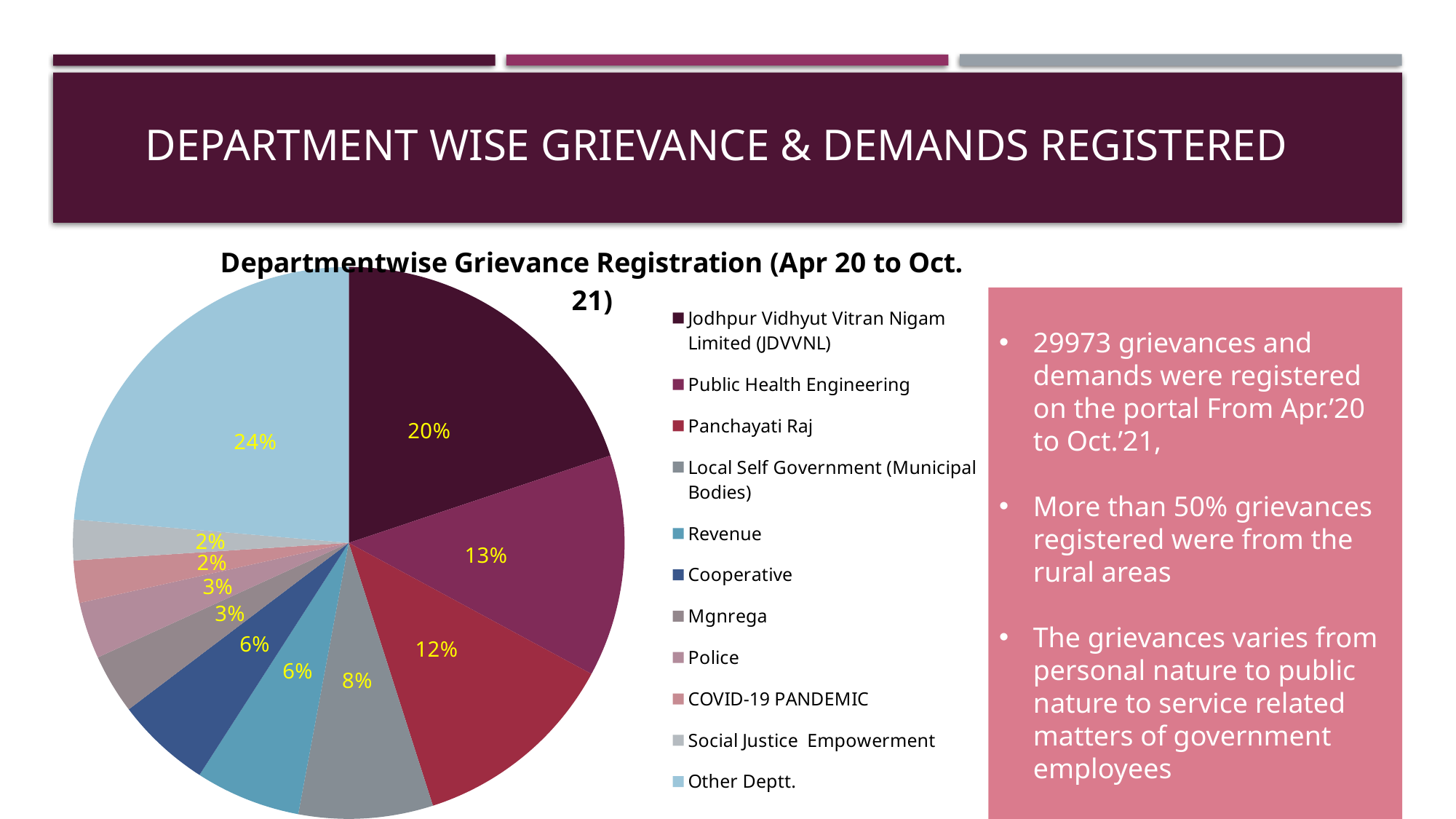
How many categories does the pie chart's legend list? 11 What colour is the slice for Other Deptt.? light blue What is the difference in percentage points between the Other Deptt. slice and the JDVVNL slice? 4 What share of grievances is attributed to Panchayati Raj? 12% What share of grievances is attributed to Local Self Government (Municipal Bodies)? 8% Which is larger, the share for Public Health Engineering or the share for Panchayati Raj? Public Health Engineering What share of grievances is attributed to Public Health Engineering? 13% What share of grievances is attributed to Other Deptt.? 24% Which category has the largest slice of the pie chart? Other Deptt. What type of chart is shown on the slide? pie chart What share of grievances is attributed to Jodhpur Vidhyut Vitran Nigam Limited (JDVVNL)? 20% What is the title of the pie chart? Departmentwise Grievance Registration (Apr 20 to Oct. 21)